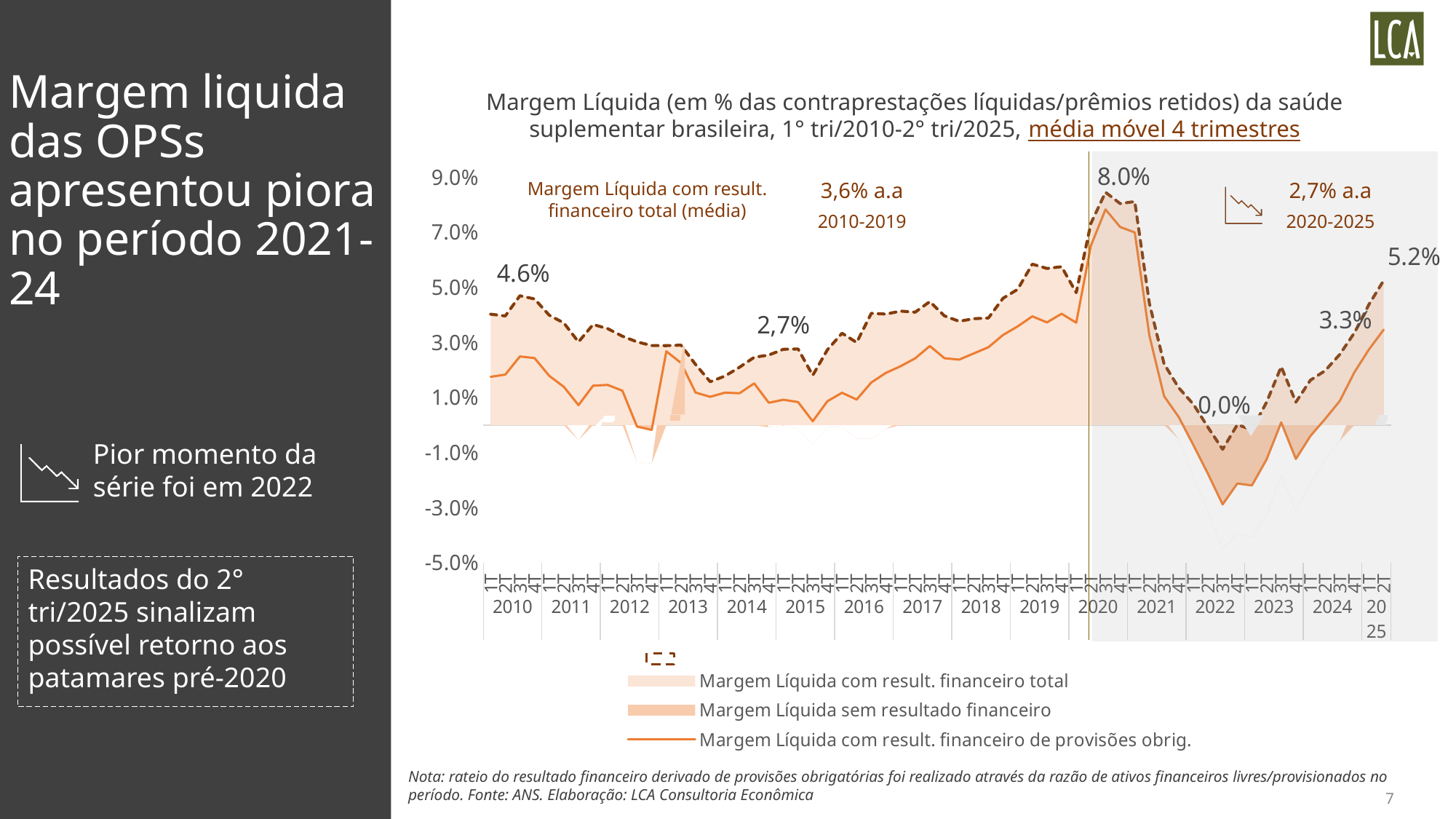
What is the highest value labeled on the chart, reached in 2020? 8.0% What is the difference between the 5.2% value in 2T 2025 and the 3.3% value labeled in 2024? 1.9 percentage points Which is larger: the value labeled in 2010 (4.6%) or the value labeled in 2020 (8.0%)? 8.0% in 2020 What is the difference between the 8.0% peak in 2020 and the 5.2% value in 2T 2025? 2.8 percentage points What average annual rate is annotated for the period 2010-2019? 3,6% a.a What value is labeled at the start of the series, in 2010? 4.6% What kind of chart is shown on the slide? combination area and line chart Do the values rise or fall from 3T 2022 to 2T 2025? rise What average annual rate is annotated for the period 2020-2025? 2,7% a.a What value is labeled for the low point of the series in 2022? 0,0% Is the value of the solid line 'Margem Líquida com result. financeiro de provisões obrig.' at 3T 2022 greater or less than -1.0%? less What value is labeled at the end of the series, in 2T 2025? 5.2%